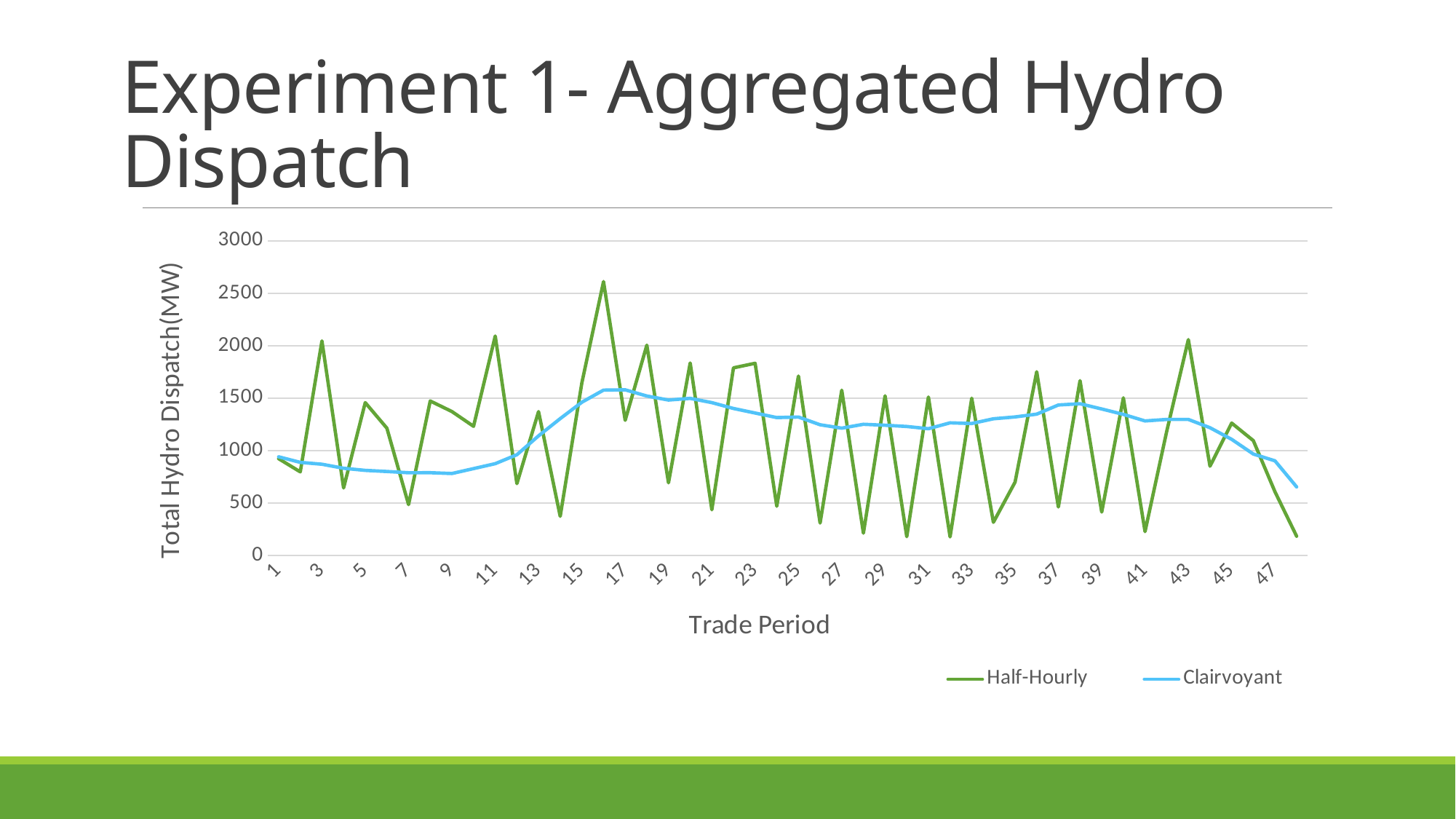
At trade period 7, which series has the larger value, Half-Hourly or Clairvoyant? Clairvoyant Does the Clairvoyant series rise or fall between trade period 43 and trade period 48? fall What is the label of the vertical axis? Total Hydro Dispatch(MW) How many series does the legend list? 2 Which series reaches the lowest value anywhere on the chart? Half-Hourly Is the Clairvoyant value at trade period 17 greater or less than 1000? greater Is the Clairvoyant value at trade period 7 greater or less than 1000? less Is the Half-Hourly value at trade period 48 greater or less than 500? less What kind of chart is shown on the slide? line chart Which series reaches the highest value anywhere on the chart? Half-Hourly What are the two series named in the legend? Half-Hourly and Clairvoyant